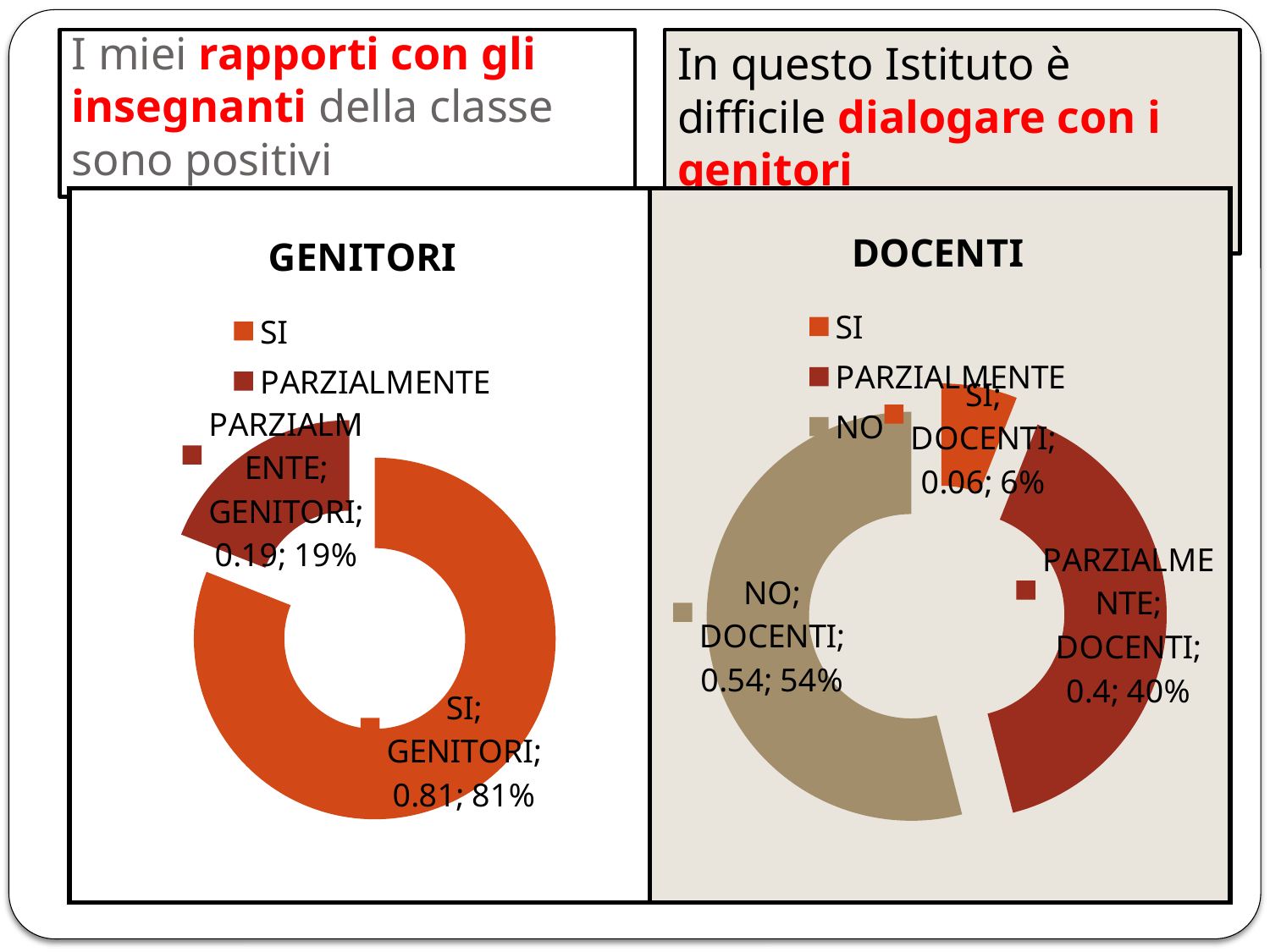
In the DOCENTI chart, which is larger, the share for NO or the share for PARZIALMENTE? NO How many categories does the DOCENTI chart show? 3 How many entries does the legend of the GENITORI chart list? 2 In the GENITORI chart, what is the difference in percentage points between SI and PARZIALMENTE? 62 In the DOCENTI chart, which category has the largest share? NO In the GENITORI chart, what percentage is shown for PARZIALMENTE? 19% In the DOCENTI chart, what value is shown for SI? 0.06; 6% In the DOCENTI chart, which category has the smallest share? SI In the DOCENTI chart, what percentage is shown for PARZIALMENTE? 40% What kind of chart is the GENITORI chart? doughnut chart In the DOCENTI chart, what percentage is shown for NO? 54% In the GENITORI chart, what percentage is shown for SI? 81%